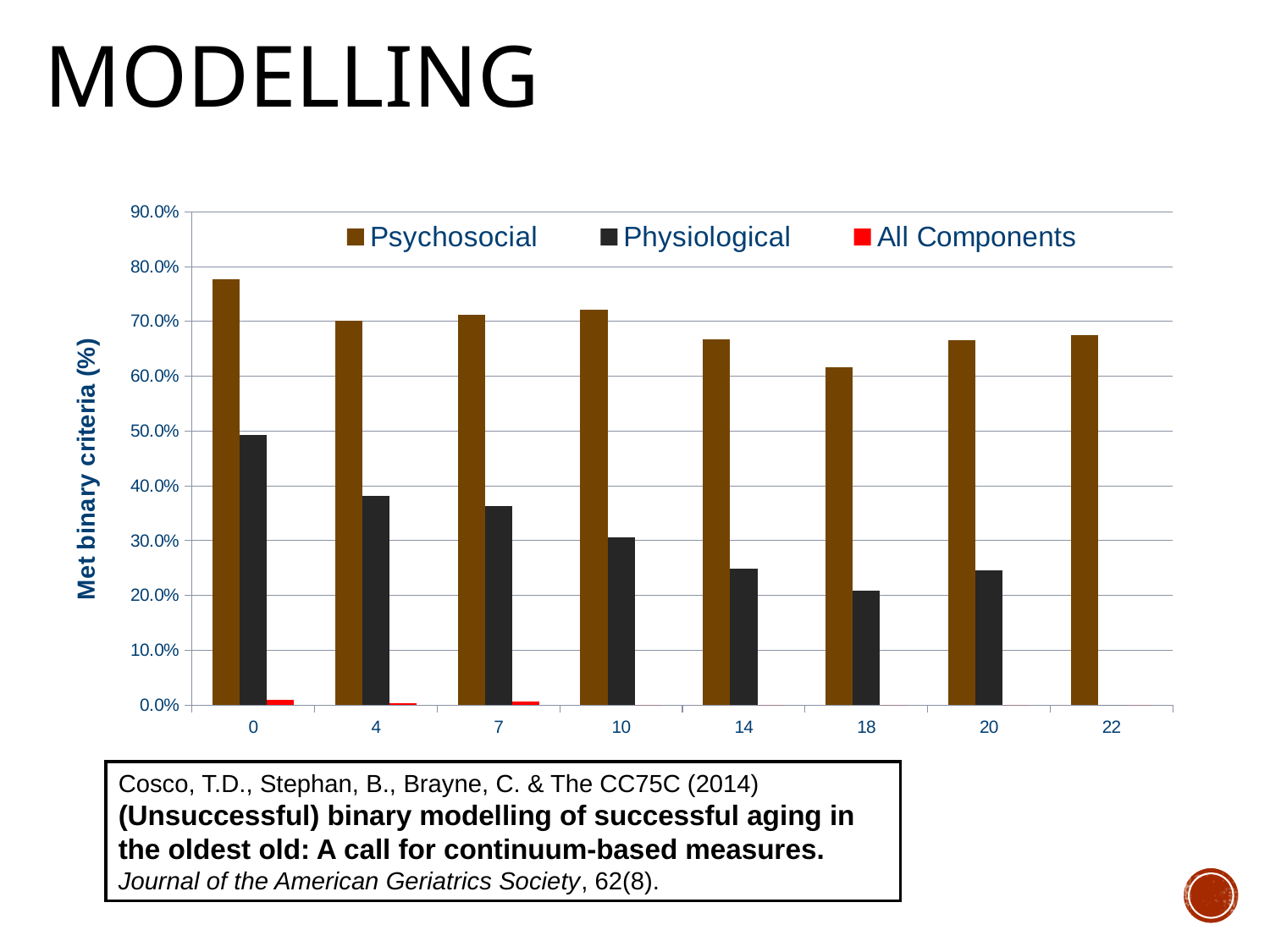
What is the label on the vertical axis? Met binary criteria (%) How many categories are shown along the x axis? 8 Is the Psychosocial value at category 0 greater or less than 70.0%? greater At which x-axis category is the Psychosocial bar lowest? 18 At which x-axis category is the Psychosocial bar highest? 0 What kind of chart is shown on the slide? bar chart Is the Physiological value at category 0 greater or less than 40.0%? greater Which is larger, the Physiological value at category 10 or at category 14? category 10 Is the Physiological value at category 14 greater or less than 30.0%? less How many series does the legend list? 3 At which x-axis category is the Physiological bar highest? 0 Do the Physiological values generally rise or fall from category 0 to category 20? fall